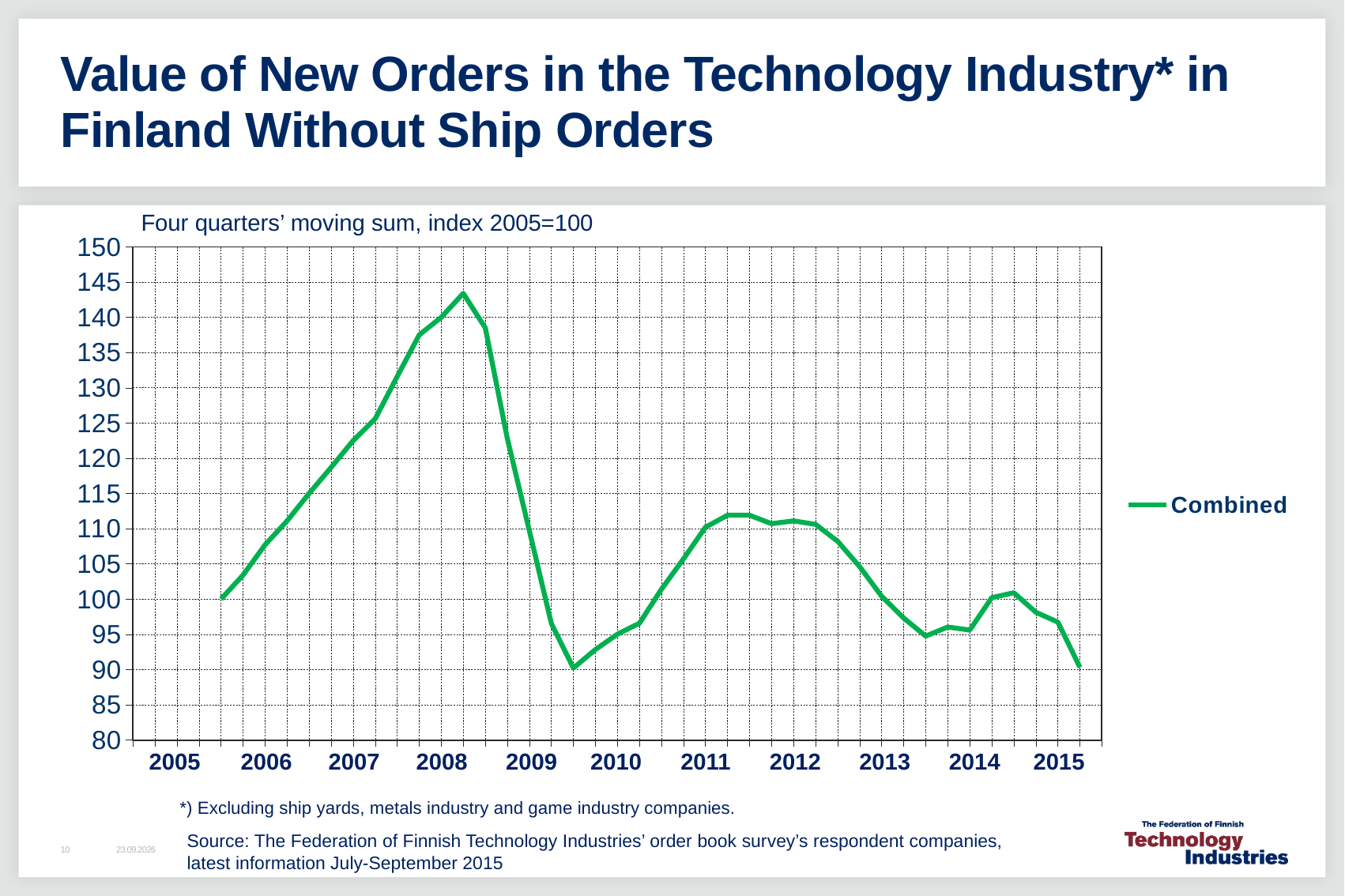
Which is larger, the Combined index at its 2008 peak or at its 2011 peak? 2008 Is the peak value of the Combined index in 2008 greater or less than 140? greater How many series does the legend list? 1 Is the lowest value of the Combined index in 2009 greater or less than 95? less Does the Combined index rise or fall between 2008 and 2009? fall How many year labels are shown on the x axis? 11 What is the name of the series shown in the legend? Combined In which year does the Combined index reach its highest value? 2008 What subtitle is printed above the chart? Four quarters' moving sum, index 2005=100 Does the Combined index rise or fall between 2005 and 2008? rise What kind of chart is shown on the slide? line chart